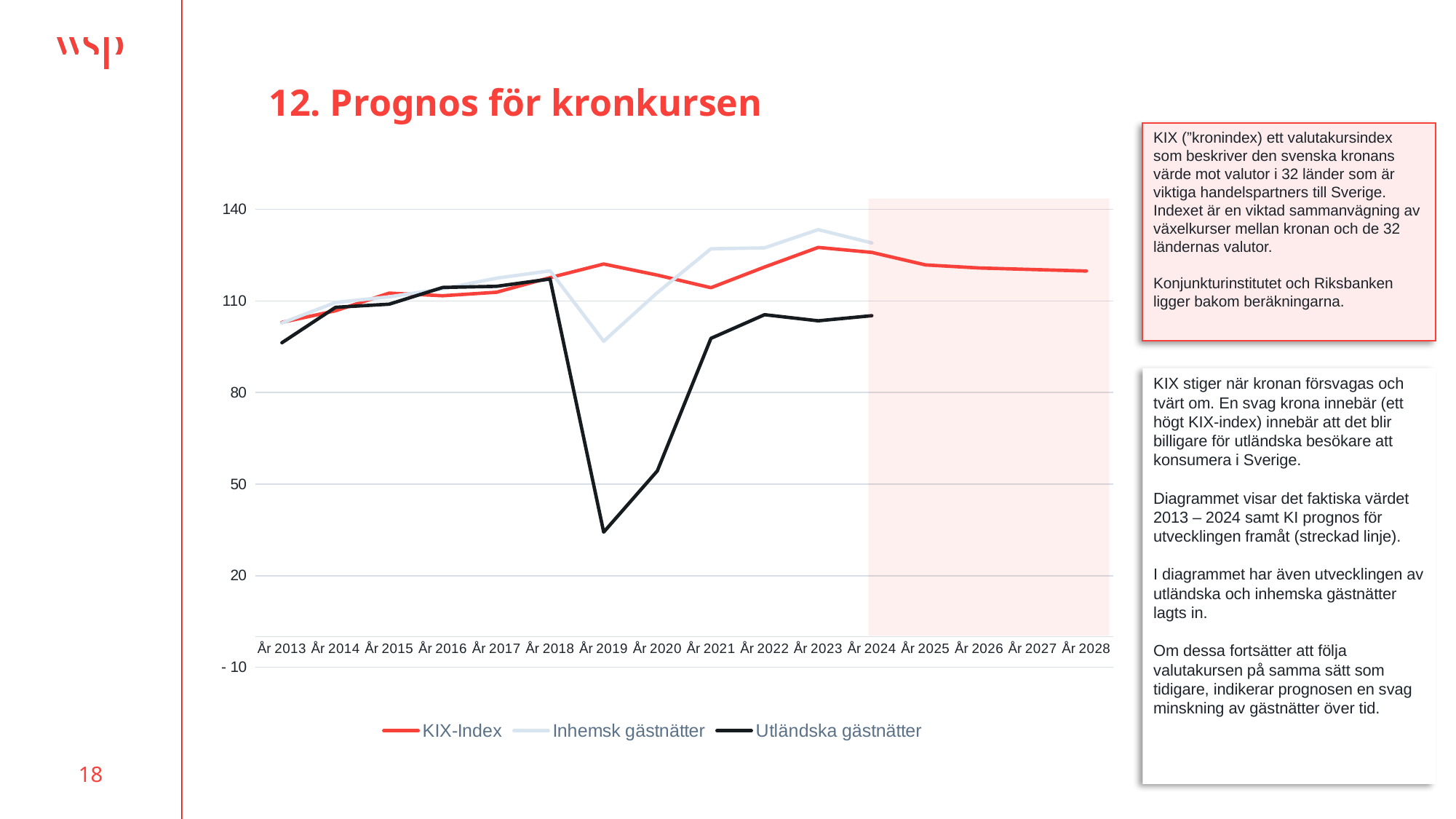
Does Utländska gästnätter rise or fall between År 2019 and År 2022? rise How many years are shown along the x axis? 16 Is the value for Utländska gästnätter in År 2019 greater or less than 50? less What is the title of the slide containing the chart? 12. Prognos för kronkursen Which series is drawn in red? KIX-Index How many series does the legend list? 3 In År 2023, which is higher: Inhemsk gästnätter or Utländska gästnätter? Inhemsk gästnätter What kind of chart is shown on the slide? line chart In År 2019, which is higher: KIX-Index or Utländska gästnätter? KIX-Index Is the value for KIX-Index in År 2023 greater or less than 110? greater In which year does Utländska gästnätter reach its lowest value? År 2019 Is the value for Inhemsk gästnätter in År 2019 greater or less than 110? less